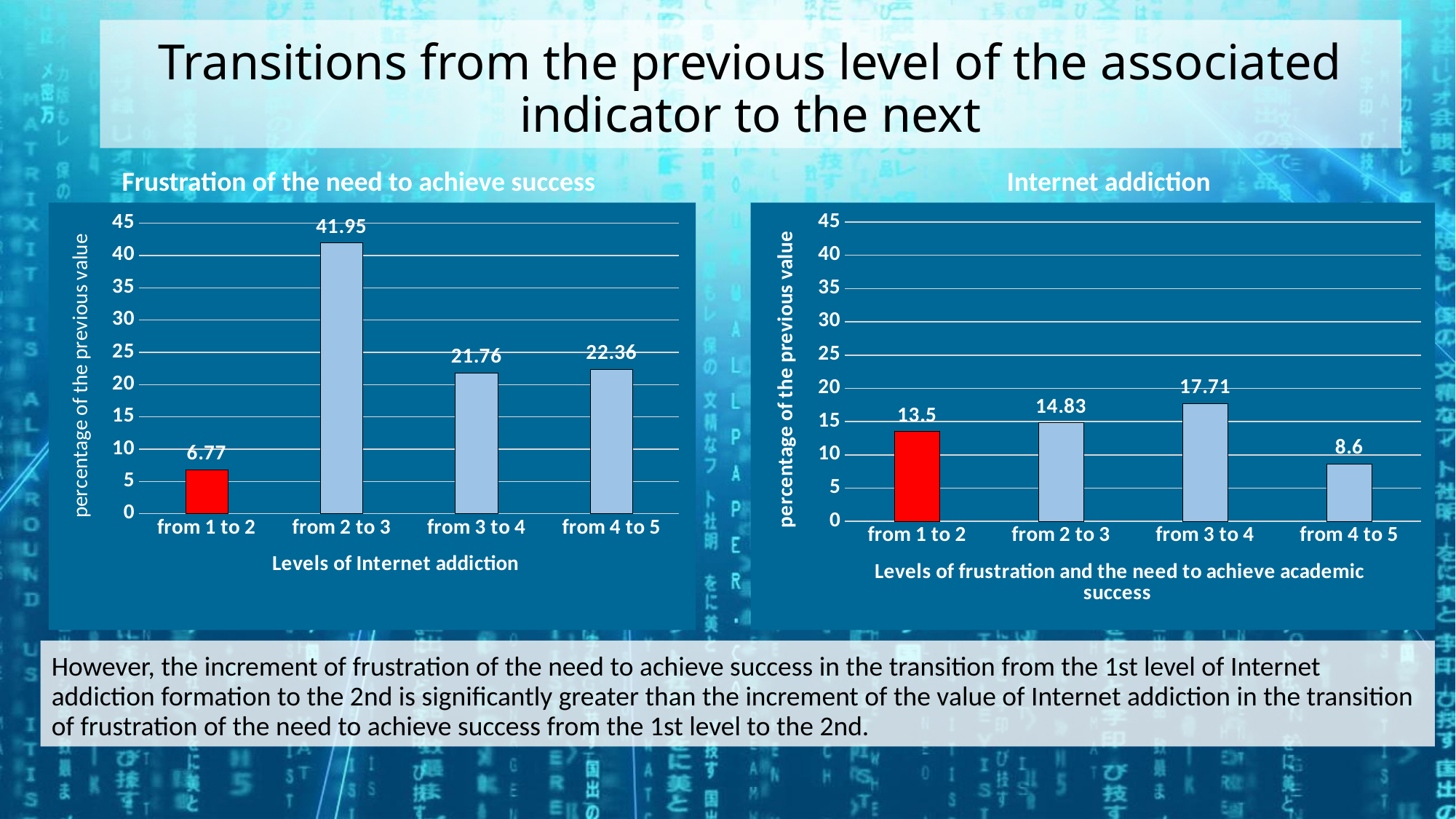
In the 'Internet addiction' chart, which category has the highest value? from 3 to 4 In the 'Frustration of the need to achieve success' chart, what is the difference between the values for 'from 4 to 5' and 'from 3 to 4'? 0.6 In the 'Internet addiction' chart, is the value for 'from 2 to 3' greater or less than 10? greater In the 'Frustration of the need to achieve success' chart, which category has the lowest value? from 1 to 2 In the 'Frustration of the need to achieve success' chart, what is the value for 'from 2 to 3'? 41.95 Which is larger: the 'from 1 to 2' value in the 'Frustration of the need to achieve success' chart or the 'from 1 to 2' value in the 'Internet addiction' chart? Internet addiction (13.5) In the 'Frustration of the need to achieve success' chart, what is the x-axis title? Levels of Internet addiction How many categories are shown on the x axis of the 'Frustration of the need to achieve success' chart? 4 In the 'Internet addiction' chart, what is the value for 'from 4 to 5'? 8.6 In the 'Internet addiction' chart, what is the difference between the values for 'from 3 to 4' and 'from 1 to 2'? 4.21 In the 'Internet addiction' chart, which bar is coloured red? from 1 to 2 What kind of chart is the 'Internet addiction' chart? bar chart